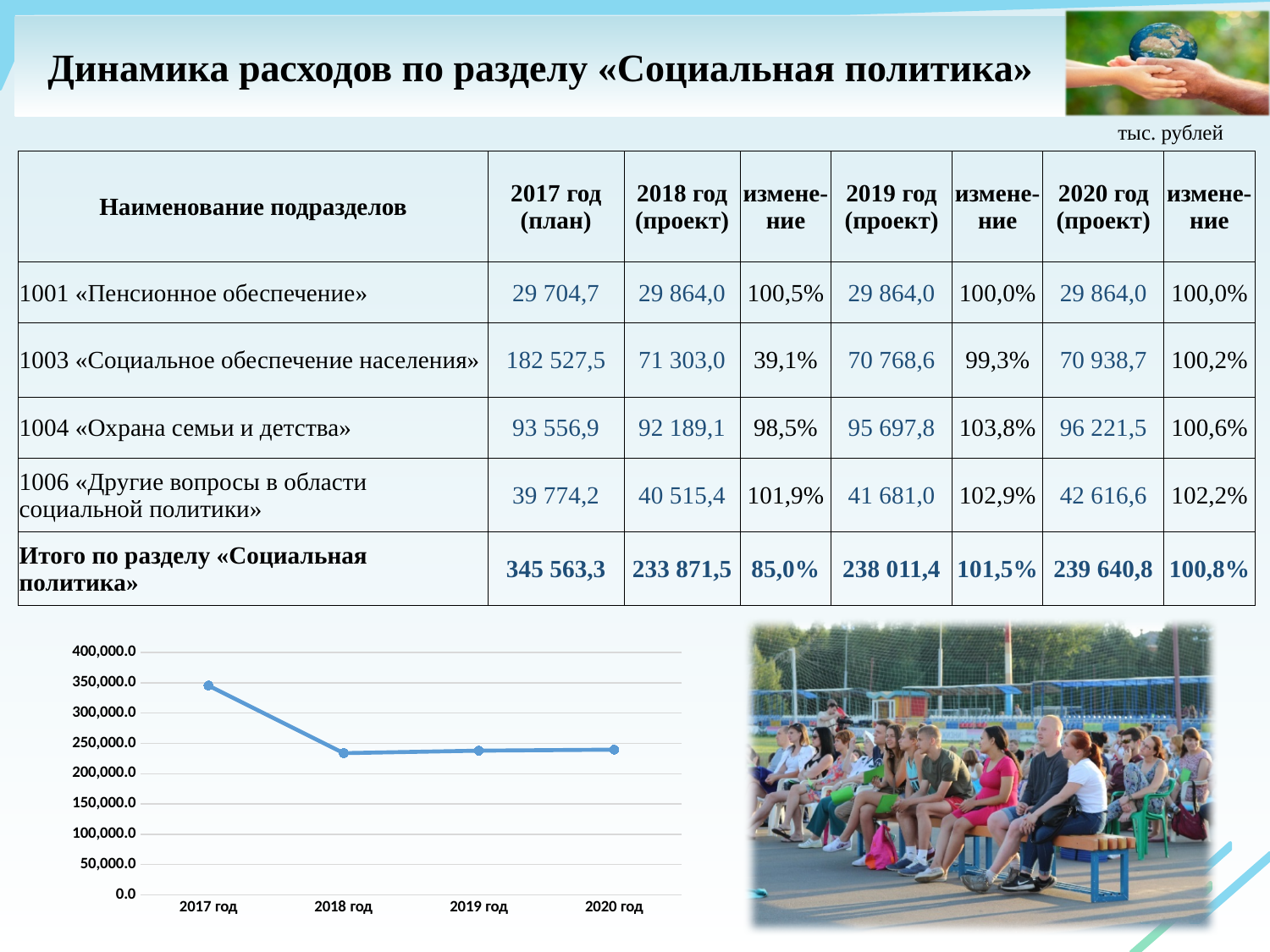
What kind of chart is shown at the bottom left of the slide? line chart Does the line on the chart rise or fall between 2017 год and 2018 год? fall On the line chart, is the value for 2018 год greater or less than 250,000.0? less On the line chart, is the value for 2017 год greater or less than 300,000.0? greater What is the label of the first category on the horizontal axis of the line chart? 2017 год On the line chart, which is larger: the value for 2017 год or the value for 2018 год? 2017 год On the line chart, is the value for 2020 год greater or less than 250,000.0? less What is the highest tick value shown on the vertical axis of the line chart? 400,000.0 Which year has the highest value on the line chart? 2017 год How many data points are plotted on the line chart? 4